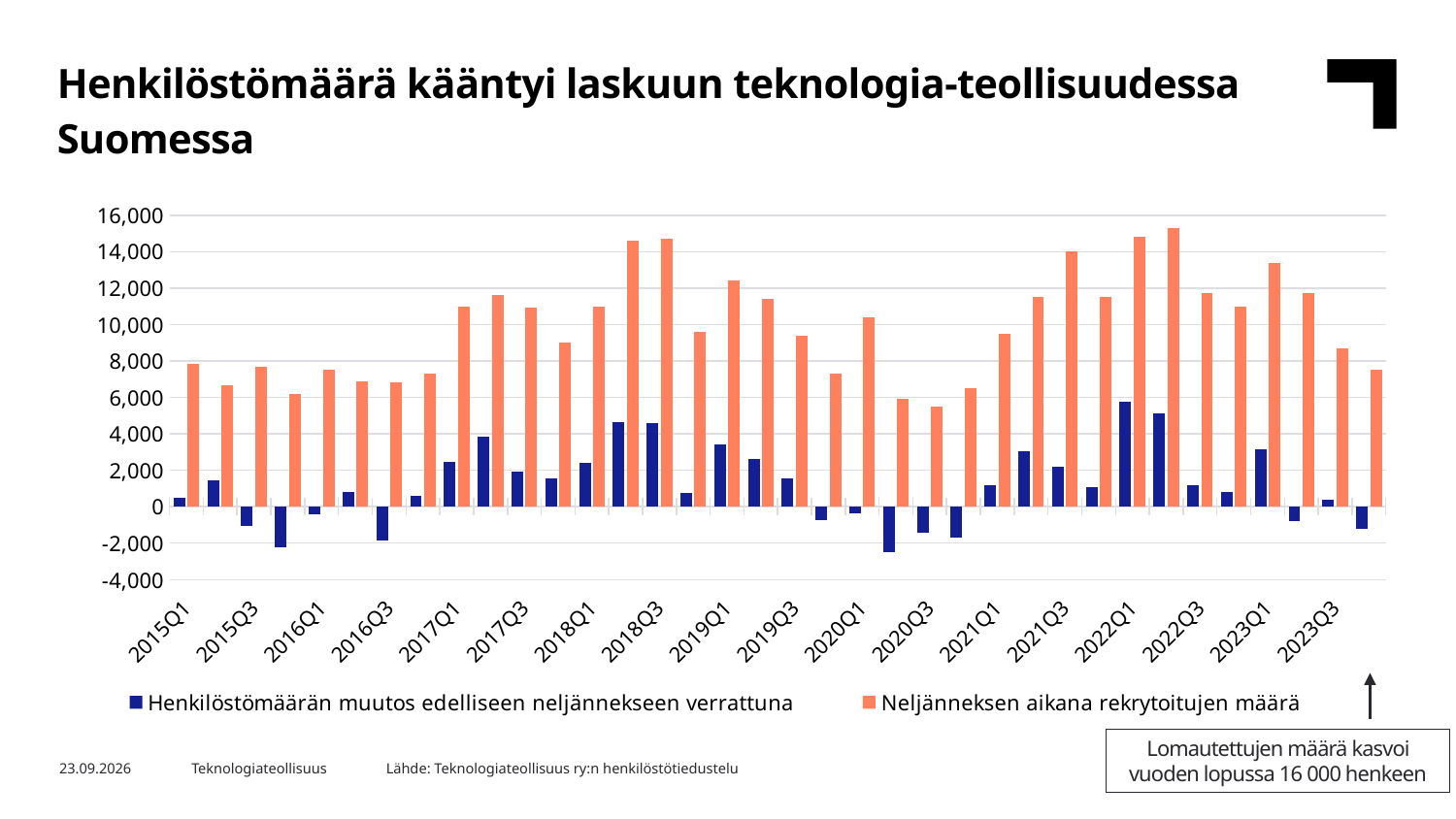
Is the value for Henkilöstömäärän muutos edelliseen neljännekseen verrattuna in 2017Q2 greater or less than 2,000? greater Which is larger for Neljänneksen aikana rekrytoitujen määrä: 2018Q3 or 2015Q1? 2018Q3 What kind of chart is shown on the slide? bar chart Which series is shown in orange in the legend? Neljänneksen aikana rekrytoitujen määrä Does the value for Neljänneksen aikana rekrytoitujen määrä rise or fall from 2020Q3 to 2022Q2? rise How many quarters are plotted on the x axis, from 2015Q1 to 2023Q4? 36 Is the value for Neljänneksen aikana rekrytoitujen määrä in 2020Q3 greater or less than 6,000? less Is the value for Henkilöstömäärän muutos edelliseen neljännekseen verrattuna in 2020Q2 greater or less than -2,000? less Which quarter has the highest value for Henkilöstömäärän muutos edelliseen neljännekseen verrattuna? 2022Q1 Which quarter has the highest value for Neljänneksen aikana rekrytoitujen määrä? 2022Q2 How many series does the legend list? 2